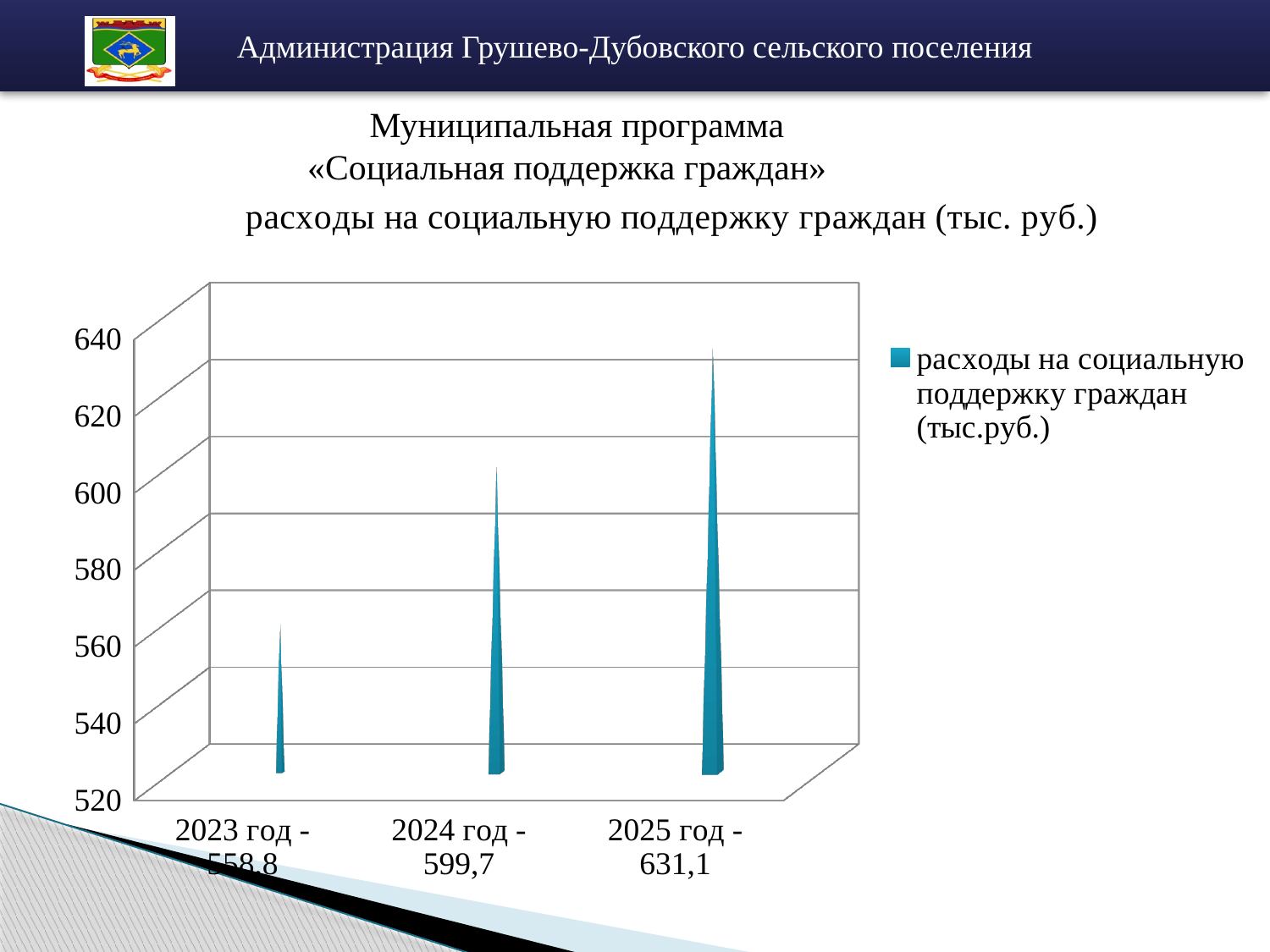
Is the value for 2023 год greater or less than 580? less Which year has the lowest value? 2023 год What is the value for 2025 год? 631,1 Do the values rise or fall from 2023 год to 2025 год? rise How many series does the legend list? 1 What is the value for 2024 год? 599,7 Is the value for 2025 год greater or less than 620? greater Which is larger, the value for 2024 год or the value for 2025 год? 2025 год What kind of chart is shown on the slide? bar chart How many years are shown on the x axis? 3 Which year has the highest value? 2025 год What is the difference between the values for 2025 год and 2024 год? 31,4